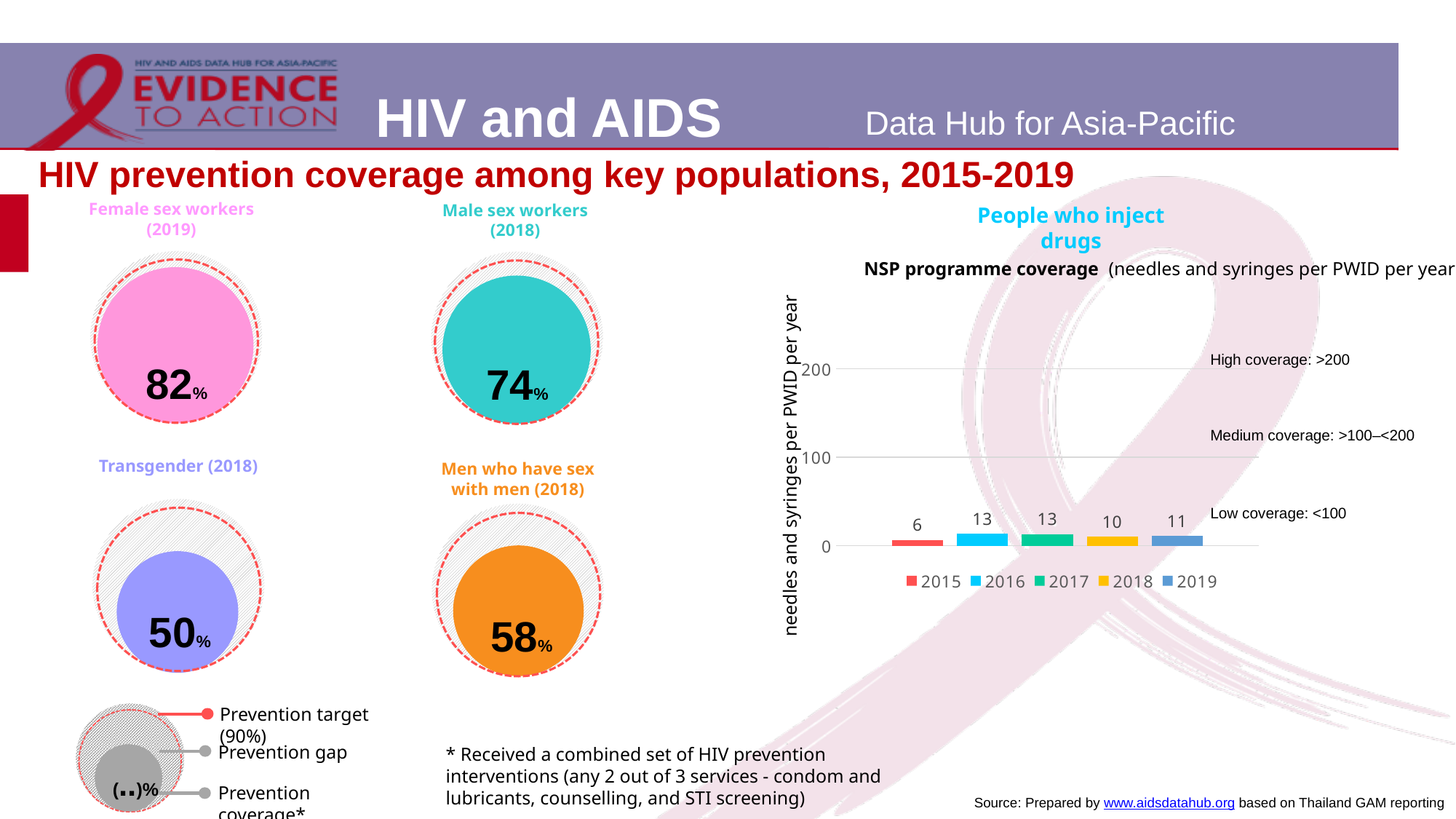
In the NSP programme coverage bar chart, what is the value for 2018? 10 In the circle graphics on the left, what is the prevention coverage for Female sex workers (2019)? 82% What kind of chart is the NSP programme coverage chart? bar chart In the NSP programme coverage bar chart, what is the value for 2015? 6 In the NSP programme coverage bar chart, which year has the lowest value? 2015 In the NSP programme coverage bar chart, what is the difference between the values for 2016 and 2015? 7 In the NSP programme coverage bar chart, what is the value for 2019? 11 In the NSP programme coverage bar chart, is the value for 2017 greater or less than 100? less In the circle graphics on the left, which key population has the lowest prevention coverage? Transgender (2018) What is the y-axis label of the NSP programme coverage bar chart? needles and syringes per PWID per year In the NSP programme coverage bar chart, which is larger, the value for 2018 or the value for 2019? 2019 How many years does the legend of the NSP programme coverage bar chart list? 5